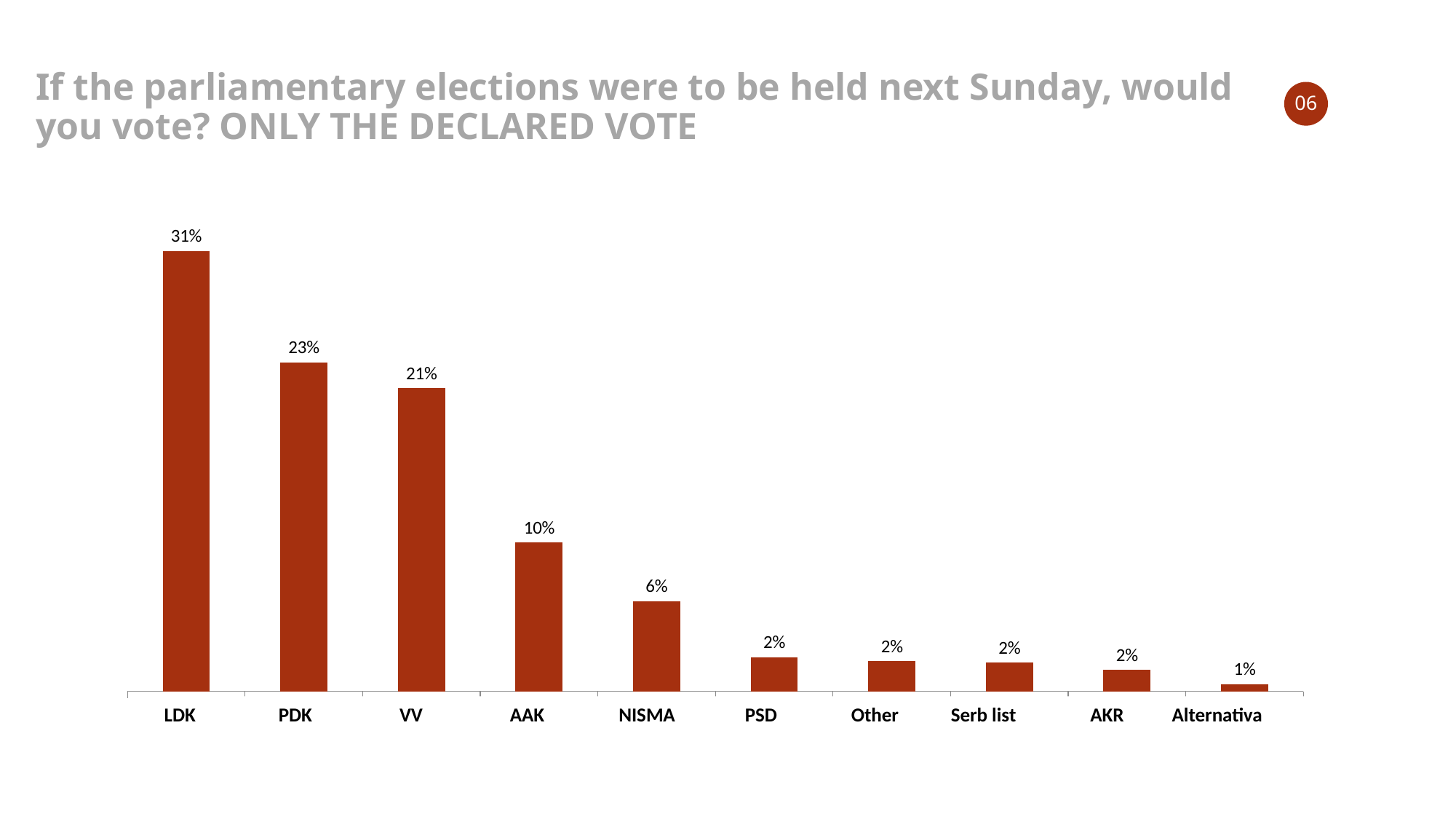
How many categories are shown on the x axis? 10 Which category has the lowest value on the chart? Alternativa Which party has the highest share of the declared vote? LDK What is the value shown for VV? 21% What is the value for Alternativa? 1% What kind of chart is shown on the slide? Bar chart What percentage is shown for NISMA? 6% What is the difference between the values for AAK and NISMA? 4% What percentage of the declared vote does LDK receive? 31% Which is larger, the value for PDK or the value for VV? PDK Do the values rise or fall moving from left to right along the x axis? Fall What is the difference between the values for LDK and PDK? 8%